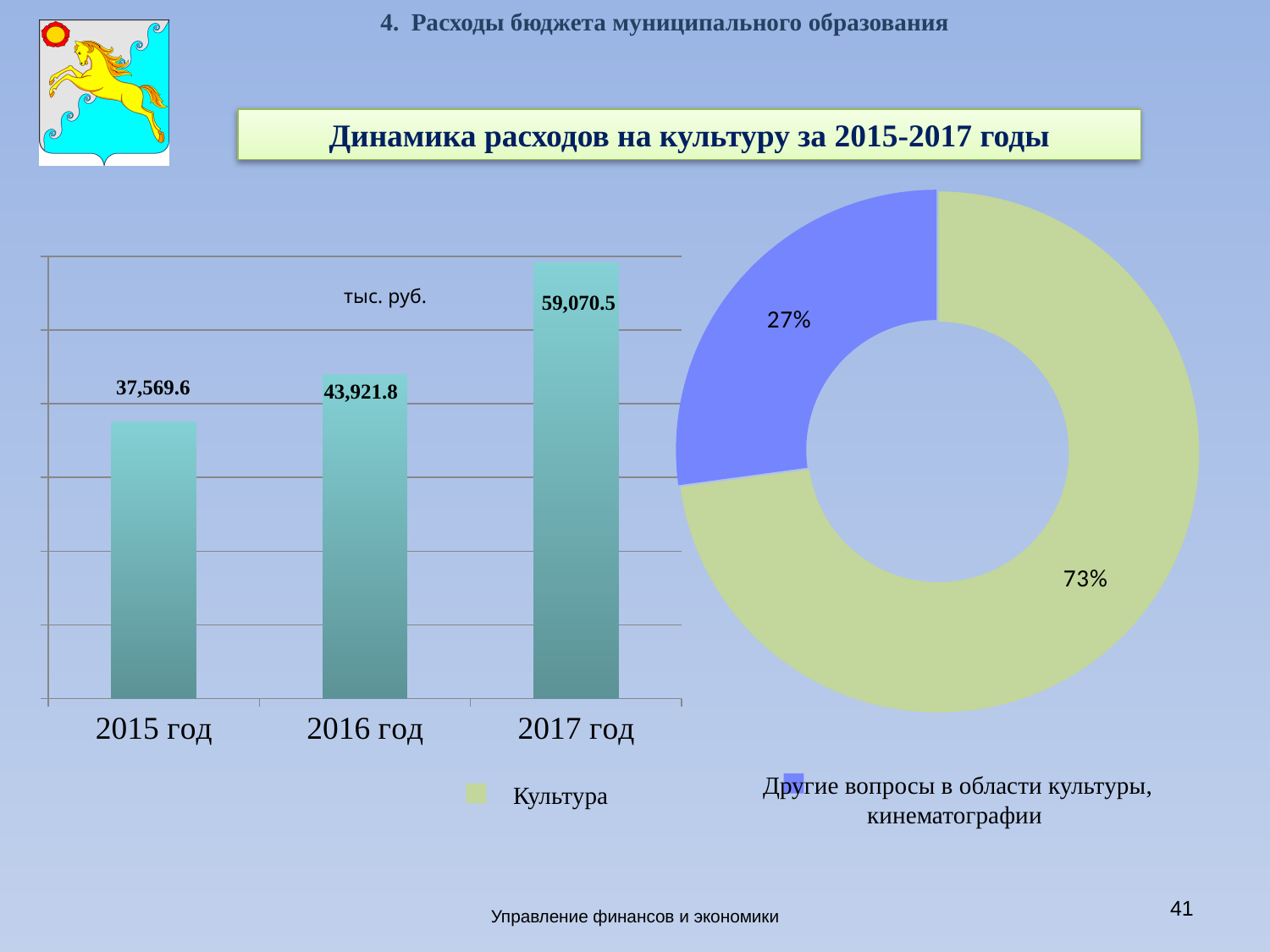
On the bar chart on the left, what is the value for 2017 год? 59,070.5 On the doughnut chart on the right, what share is labelled for Другие вопросы в области культуры, кинематографии? 27% On the bar chart on the left, which year has the highest value? 2017 год On the bar chart on the left, what is the difference between the values for 2017 год and 2015 год? 21,500.9 On the bar chart on the left, what is the value for 2016 год? 43,921.8 On the doughnut chart on the right, what share is labelled for Культура? 73% On the bar chart on the left, what is the value for 2015 год? 37,569.6 On the bar chart on the left, do the values rise or fall from 2015 год to 2017 год? rise On the bar chart on the left, which is larger: the value for 2016 год or 2017 год? 2017 год On the bar chart on the left, how many years are shown? 3 On the bar chart on the left, what is the difference between the values for 2016 год and 2015 год? 6,352.2 On the bar chart on the left, which year has the lowest value? 2015 год